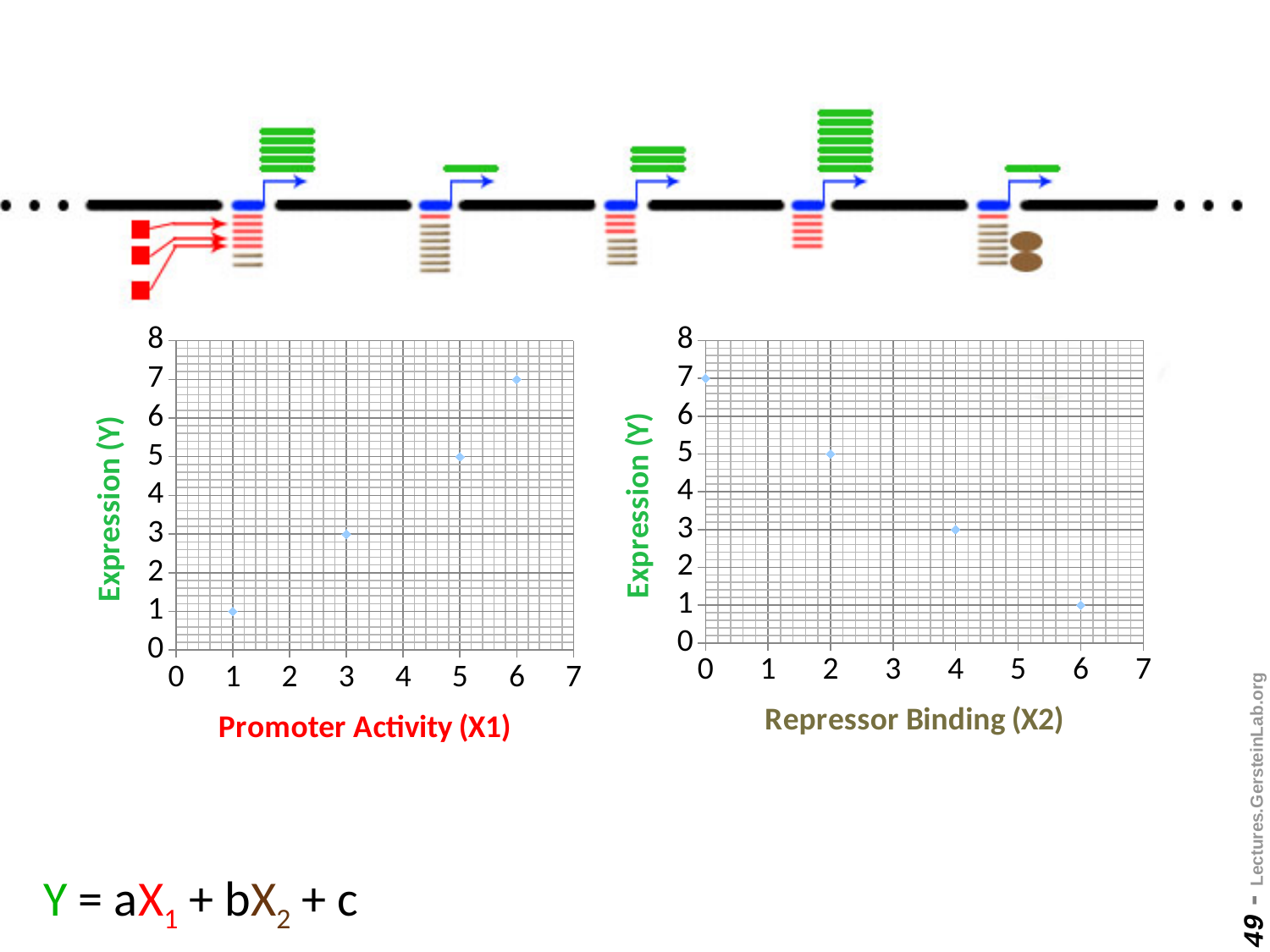
In the left chart, what is the Expression (Y) value when Promoter Activity (X1) is 6? 7 In the right chart, what is the difference in Expression (Y) between Repressor Binding (X2) of 0 and of 6? 6 In the left chart, does Expression (Y) rise or fall as Promoter Activity (X1) increases? rise In the right chart, what is the Expression (Y) value when Repressor Binding (X2) is 6? 1 In the right chart (Repressor Binding), how many data points are plotted? 4 In the right chart, does Expression (Y) rise or fall as Repressor Binding (X2) increases? fall What is the x-axis label of the right chart? Repressor Binding (X2) What kind of chart is the left chart with x axis 'Promoter Activity (X1)'? scatter chart In the left chart (Promoter Activity), how many data points are plotted? 4 In the left chart, which Promoter Activity (X1) value has the highest Expression (Y)? 6 In the right chart, what is the Expression (Y) value when Repressor Binding (X2) is 0? 7 In the left chart, what is the Expression (Y) value when Promoter Activity (X1) is 3? 3